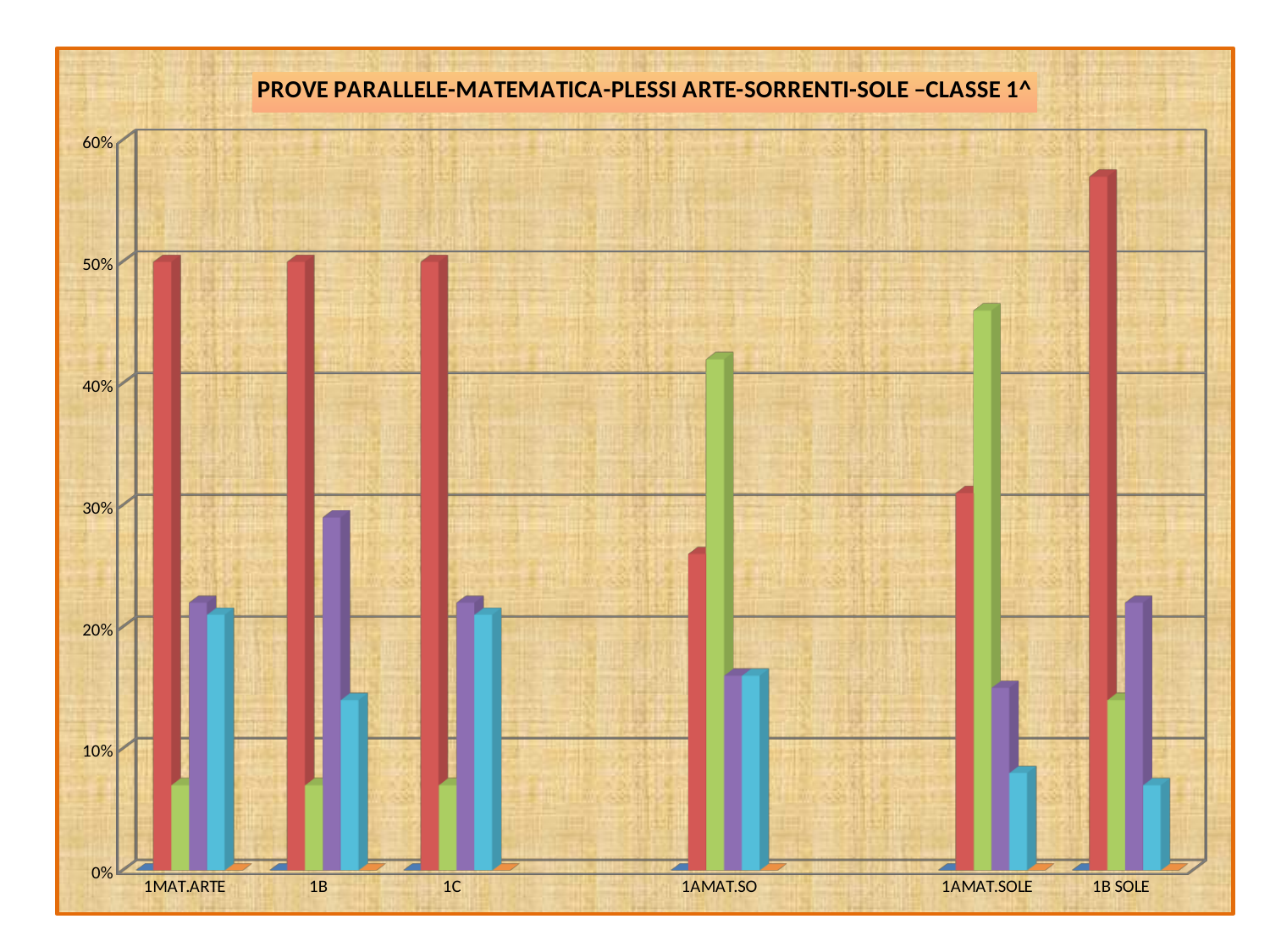
Is the value of the green bar for 1MAT.ARTE greater or less than 10%? less Is the value of the light blue bar for 1AMAT.SOLE greater or less than 10%? less Is the value of the green bar for 1AMAT.SO greater or less than 40%? greater Which category has the tallest red bar? 1B SOLE What kind of chart is shown on the slide? bar chart Which is larger, the purple bar for 1B or the purple bar for 1MAT.ARTE? 1B Which is larger, the red bar for 1AMAT.SO or the red bar for 1AMAT.SOLE? 1AMAT.SOLE Which category has the tallest green bar? 1AMAT.SOLE How many categories are shown along the x axis of the chart? 6 What is the title of the chart? PROVE PARALLELE-MATEMATICA-PLESSI ARTE-SORRENTI-SOLE –CLASSE 1^